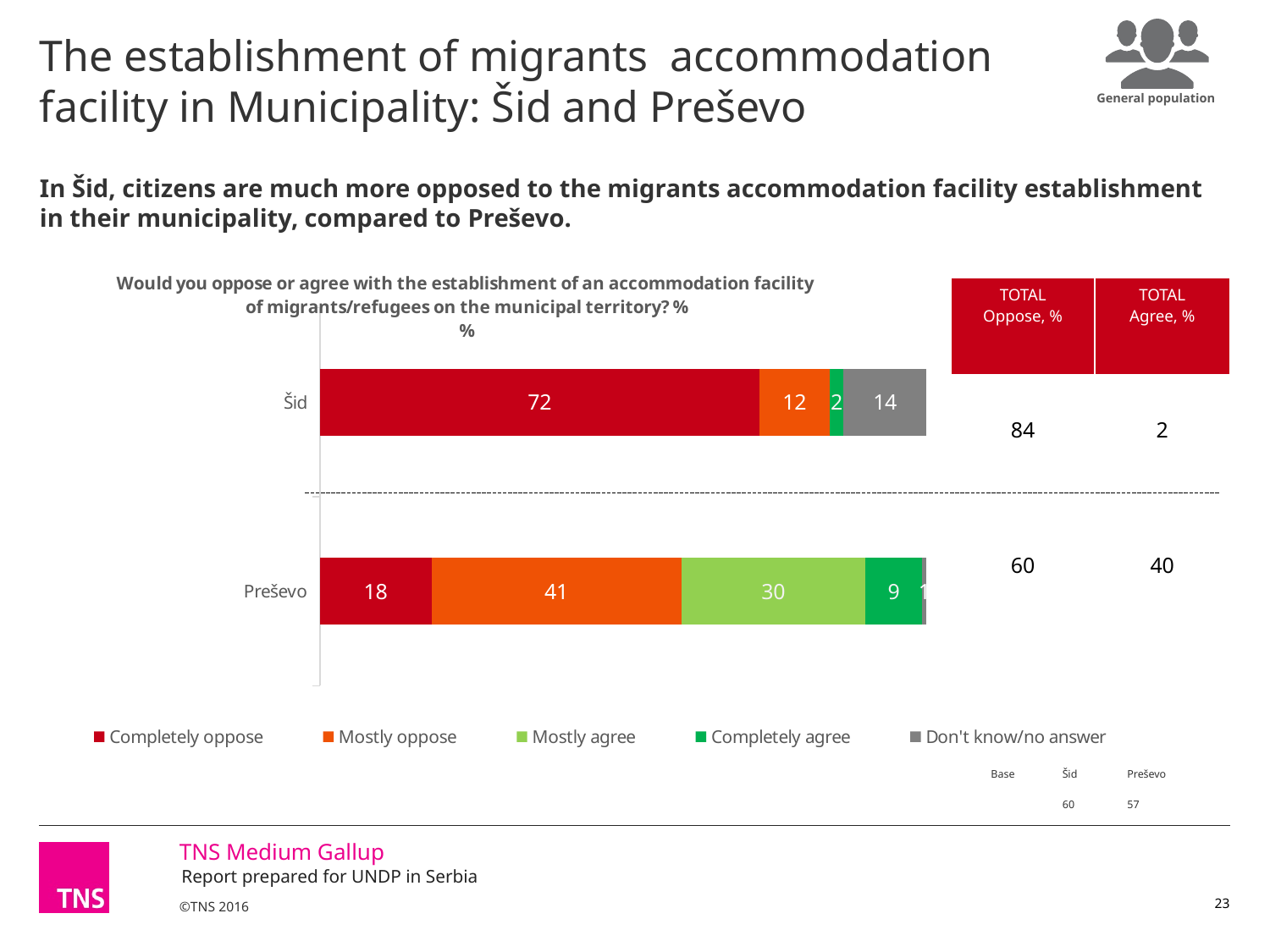
What is the 'Don't know/no answer' value for Šid? 14 What is the difference between the 'Completely oppose' values for Šid and Preševo? 54 What percentage of respondents in Preševo mostly oppose the establishment of the accommodation facility? 41 What is the TOTAL Agree percentage for Preševo? 40 How many municipalities are shown in the chart? 2 What percentage of respondents in Šid completely oppose the establishment of the accommodation facility? 72 What is the difference between the TOTAL Oppose percentages for Šid and Preševo? 24 What type of chart is shown on the slide? Stacked bar chart What is the TOTAL Oppose percentage for Šid? 84 How many series does the chart legend list? 5 What percentage of respondents in Preševo mostly agree with the establishment of the accommodation facility? 30 Which municipality has the higher 'Completely oppose' value, Šid or Preševo? Šid